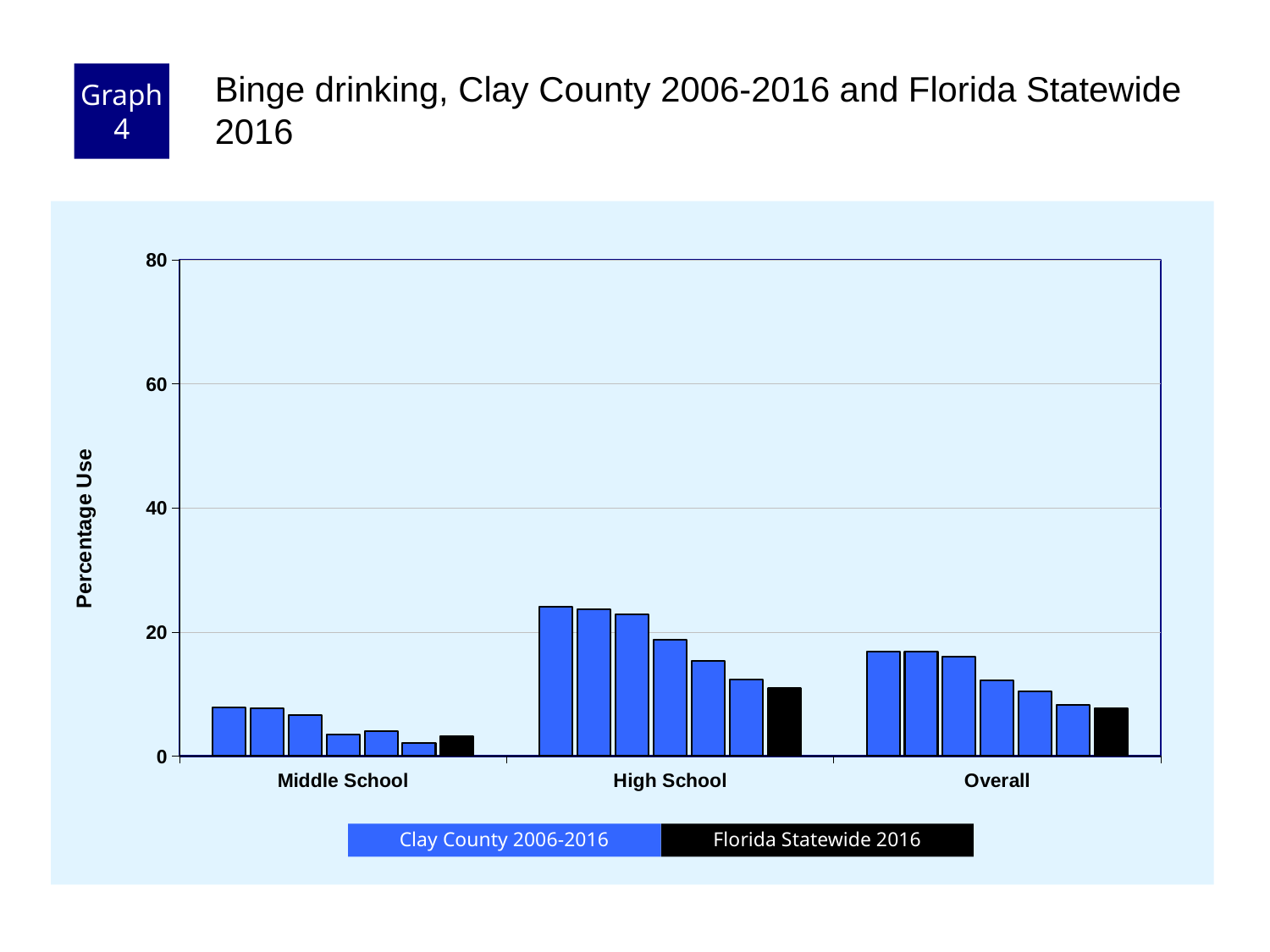
Which category has the shortest bars? Middle School Is the Florida Statewide 2016 value for Middle School greater or less than 20? less What kind of chart is shown on the slide? bar chart How many categories are shown on the x axis? 3 Which is larger, the Florida Statewide 2016 value for High School or for Middle School? High School Is the tallest Clay County bar for Overall greater or less than 20? less How many series does the legend list? 2 Within the High School group, do the Clay County 2006-2016 bars rise or fall from left to right? fall What colour are the Florida Statewide 2016 bars? black Which category has the tallest bars? High School Is the Florida Statewide 2016 value for High School greater or less than 20? less